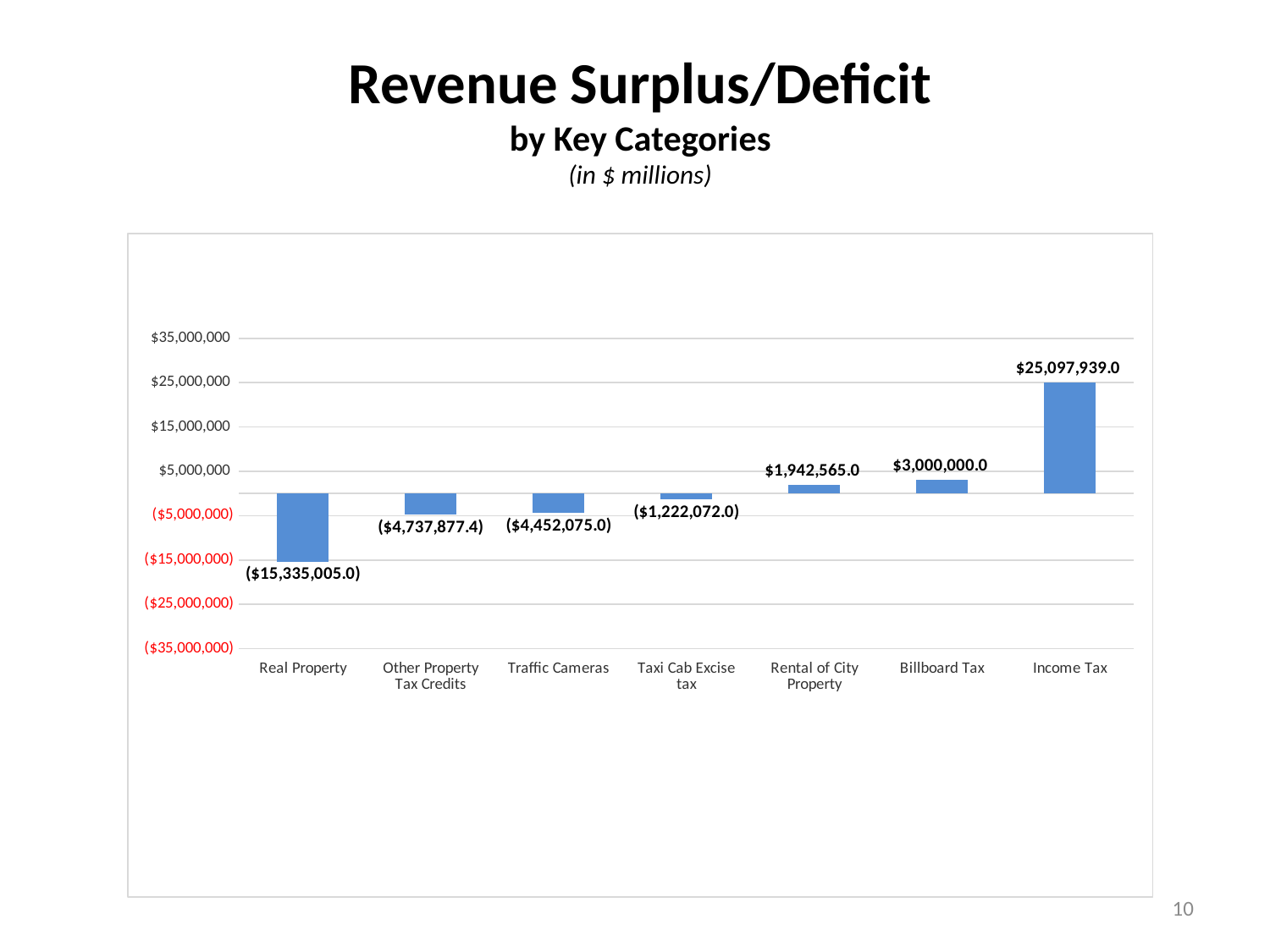
What is the value for Traffic Cameras? ($4,452,075.0) Which is larger, the value for Billboard Tax or the value for Rental of City Property? Billboard Tax What is the value for Income Tax? $25,097,939.0 What is the value for Billboard Tax? $3,000,000.0 What is the difference between the values for Income Tax and Billboard Tax? $22,097,939.0 How many categories are shown on the x axis? 7 What is the value for Real Property? ($15,335,005.0) What kind of chart is shown on the slide? bar chart Which category has the lowest value? Real Property What is the difference between the values for Billboard Tax and Rental of City Property? $1,057,435.0 Which category has the highest value? Income Tax Is the value for Income Tax greater or less than $15,000,000? greater